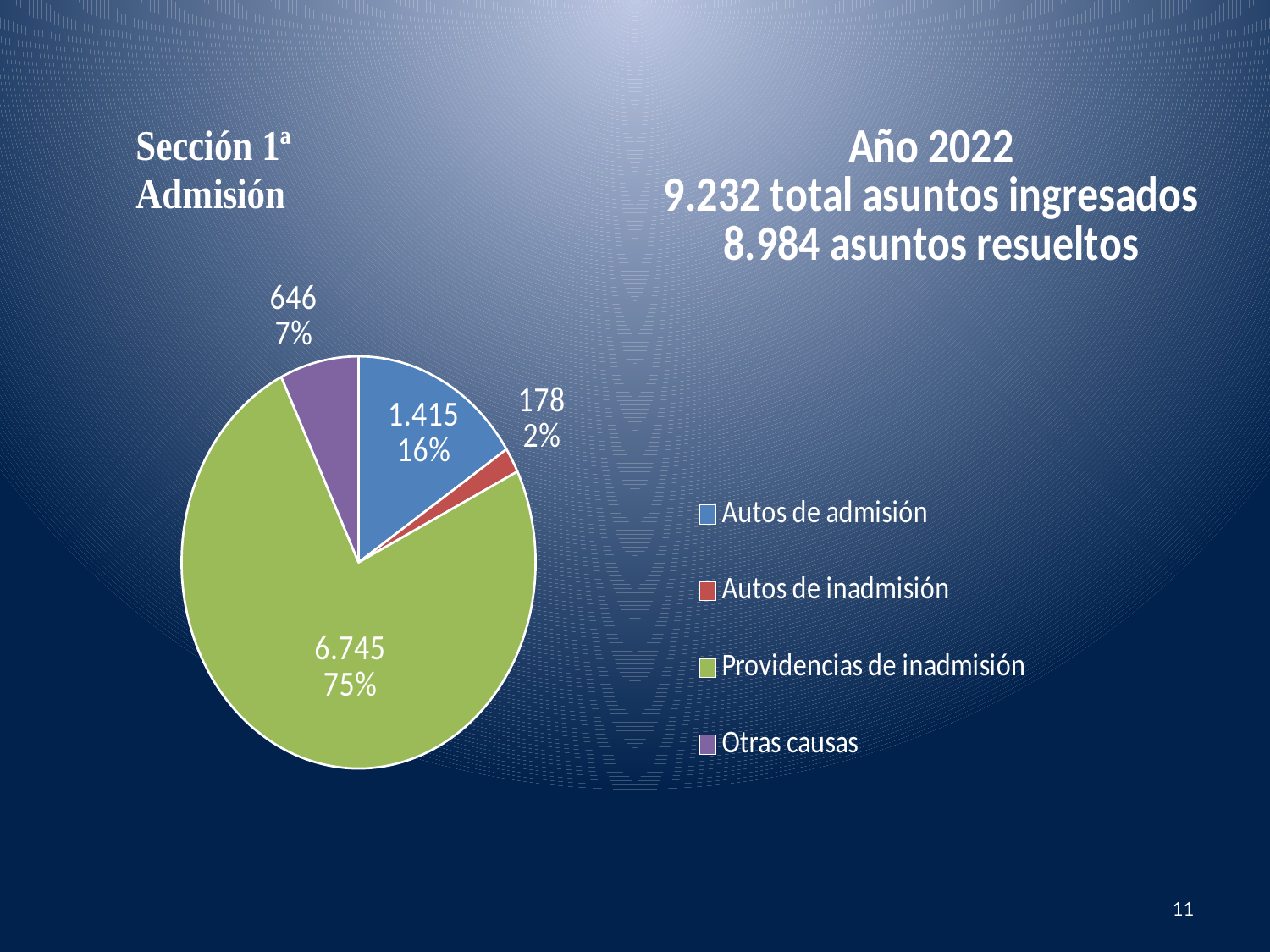
What is the value for Autos de admisión? 1.415 Which category has the smallest slice? Autos de inadmisión What is the value for Providencias de inadmisión? 6.745 What share of the pie does Autos de admisión represent? 16% Which category has the largest slice? Providencias de inadmisión How many categories does the legend list? 4 What kind of chart is shown on the slide? pie chart What share of the pie does Providencias de inadmisión represent? 75% What is the value for Otras causas? 646 Which is larger, Otras causas or Autos de admisión? Autos de admisión What is the value for Autos de inadmisión? 178 What colour is the slice for Otras causas? purple